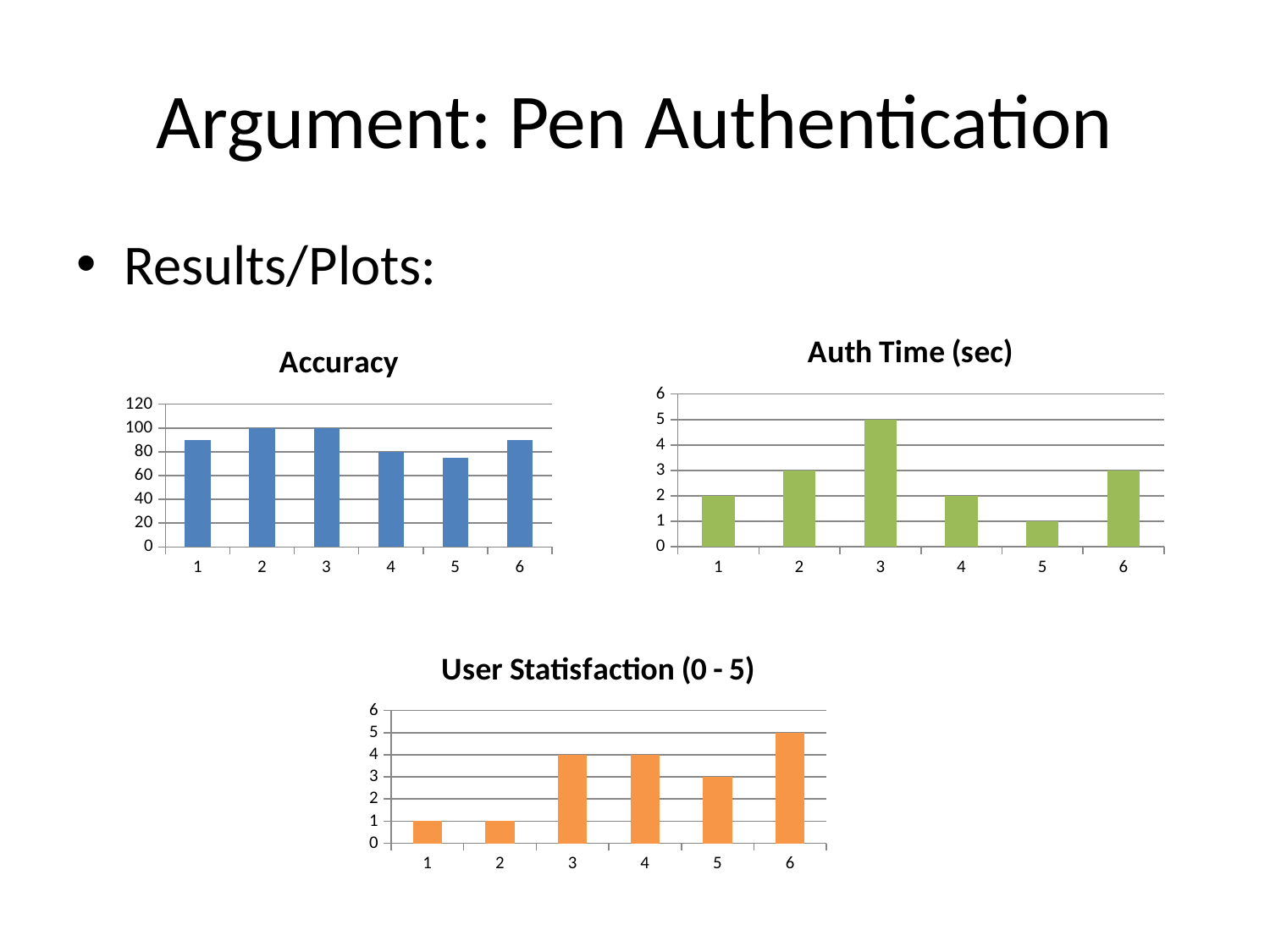
In the Accuracy chart, how many categories are shown on the x axis? 6 In the User Statisfaction (0 - 5) chart, what is the value for category 6? 5 In the Auth Time (sec) chart, what is the value for category 3? 5 What colour are the bars in the User Statisfaction (0 - 5) chart? orange What kind of chart is the Auth Time (sec) chart? bar chart In the Accuracy chart, which category has the lowest value? 5 In the Auth Time (sec) chart, which is larger, the value for category 2 or the value for category 4? category 2 In the User Statisfaction (0 - 5) chart, which category has the highest value? 6 In the User Statisfaction (0 - 5) chart, what is the difference between the values for category 6 and category 1? 4 In the Accuracy chart, what is the value for category 4? 80 In the Auth Time (sec) chart, which category has the lowest value? 5 In the Accuracy chart, is the value for category 5 greater or less than 80? less